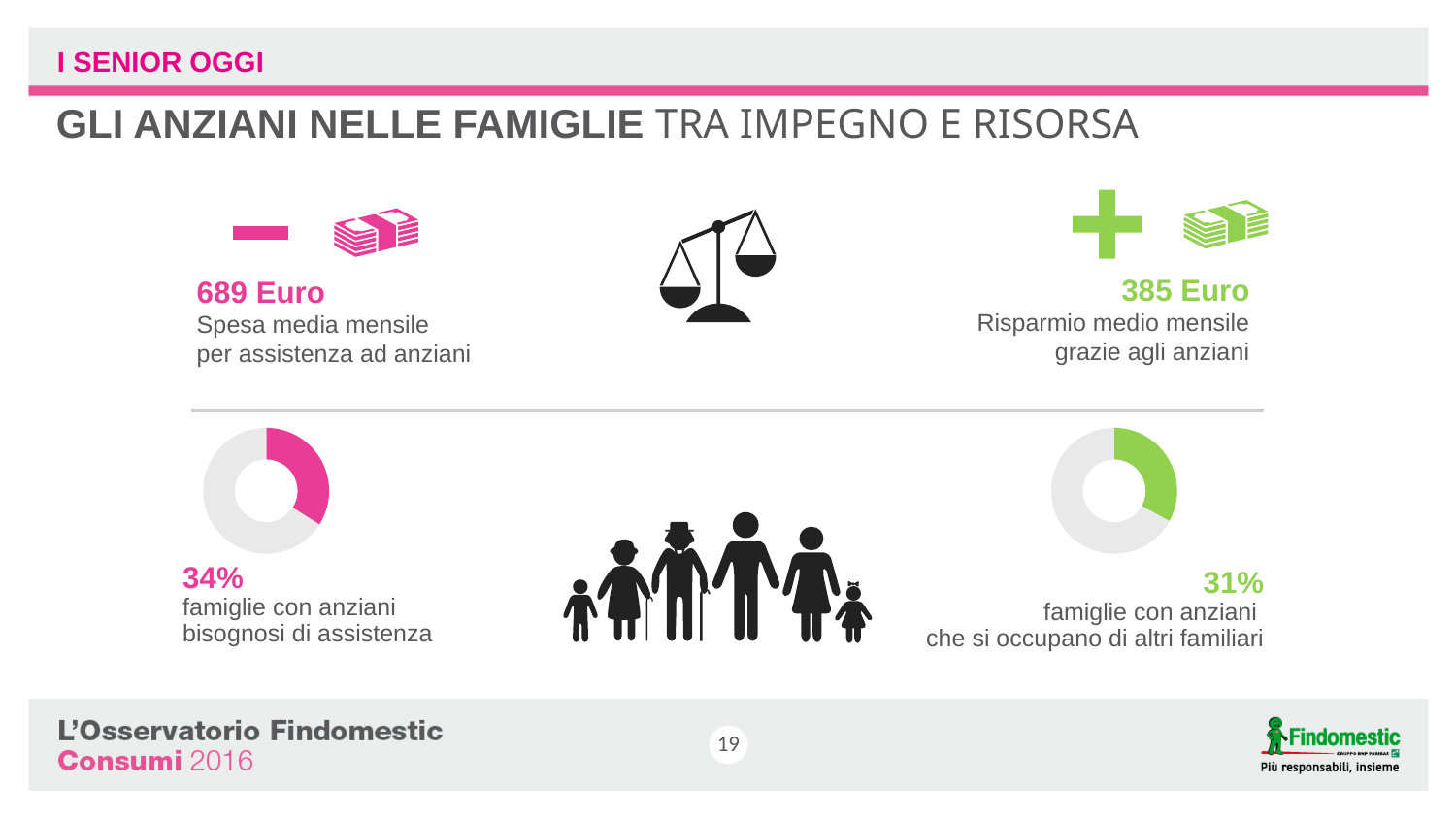
Is the value shown on the left donut chart greater or less than 50%? less What colour is the highlighted segment of the right donut chart? Green Is the value shown on the right donut chart greater or less than 25%? greater On the right donut chart, what share of the ring is highlighted in green? 31% Which is larger: the share of families with elderly needing assistance (left donut) or the share of families with elderly who care for other family members (right donut)? Families with elderly needing assistance (34%) What kind of chart is used to show the 34% and 31% figures on the slide? Donut (pie) chart On the right donut chart, what percentage of families with elderly members take care of other family members? 31% What colour is the highlighted segment of the left donut chart? Pink On the left donut chart, what share of the ring is highlighted in pink? 34% What is the difference in percentage points between the left donut chart value (34%) and the right donut chart value (31%)? 3 percentage points How many donut charts are shown on the slide? 2 On the left donut chart, what percentage of families with elderly members need assistance? 34%